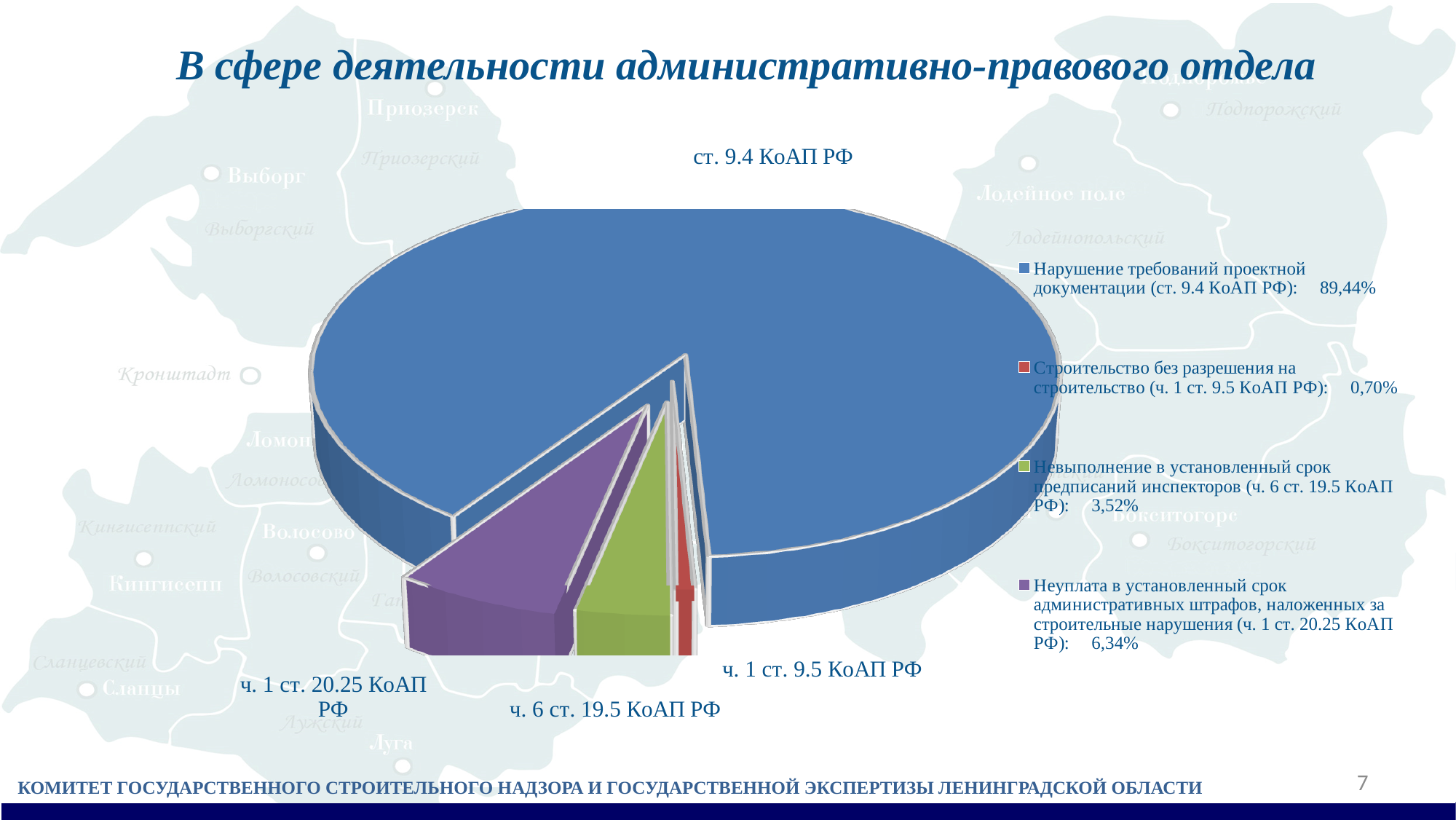
What is the difference in percentage points between the slice for ч. 1 ст. 20.25 КоАП РФ (6,34%) and the slice for ч. 6 ст. 19.5 КоАП РФ (3,52%)? 2,82% How many entries does the legend of the pie chart list? 4 What share of the pie is the slice for ч. 1 ст. 9.5 КоАП РФ (Строительство без разрешения на строительство)? 0,70% What share of the pie is the slice for ч. 1 ст. 20.25 КоАП РФ (Неуплата в установленный срок административных штрафов)? 6,34% What share of the pie is the slice for ч. 6 ст. 19.5 КоАП РФ (Невыполнение в установленный срок предписаний инспекторов)? 3,52% What kind of chart is shown on the slide? pie chart What share of the pie is the slice for ст. 9.4 КоАП РФ (Нарушение требований проектной документации)? 89,44% Which is larger: the slice for ч. 1 ст. 20.25 КоАП РФ or the slice for ч. 6 ст. 19.5 КоАП РФ? ч. 1 ст. 20.25 КоАП РФ What colour is the slice for ст. 9.4 КоАП РФ (Нарушение требований проектной документации)? blue Which slice of the pie chart is the largest? ст. 9.4 КоАП РФ (Нарушение требований проектной документации) How many slices does the pie chart have? 4 Which slice of the pie chart is the smallest? ч. 1 ст. 9.5 КоАП РФ (Строительство без разрешения на строительство)